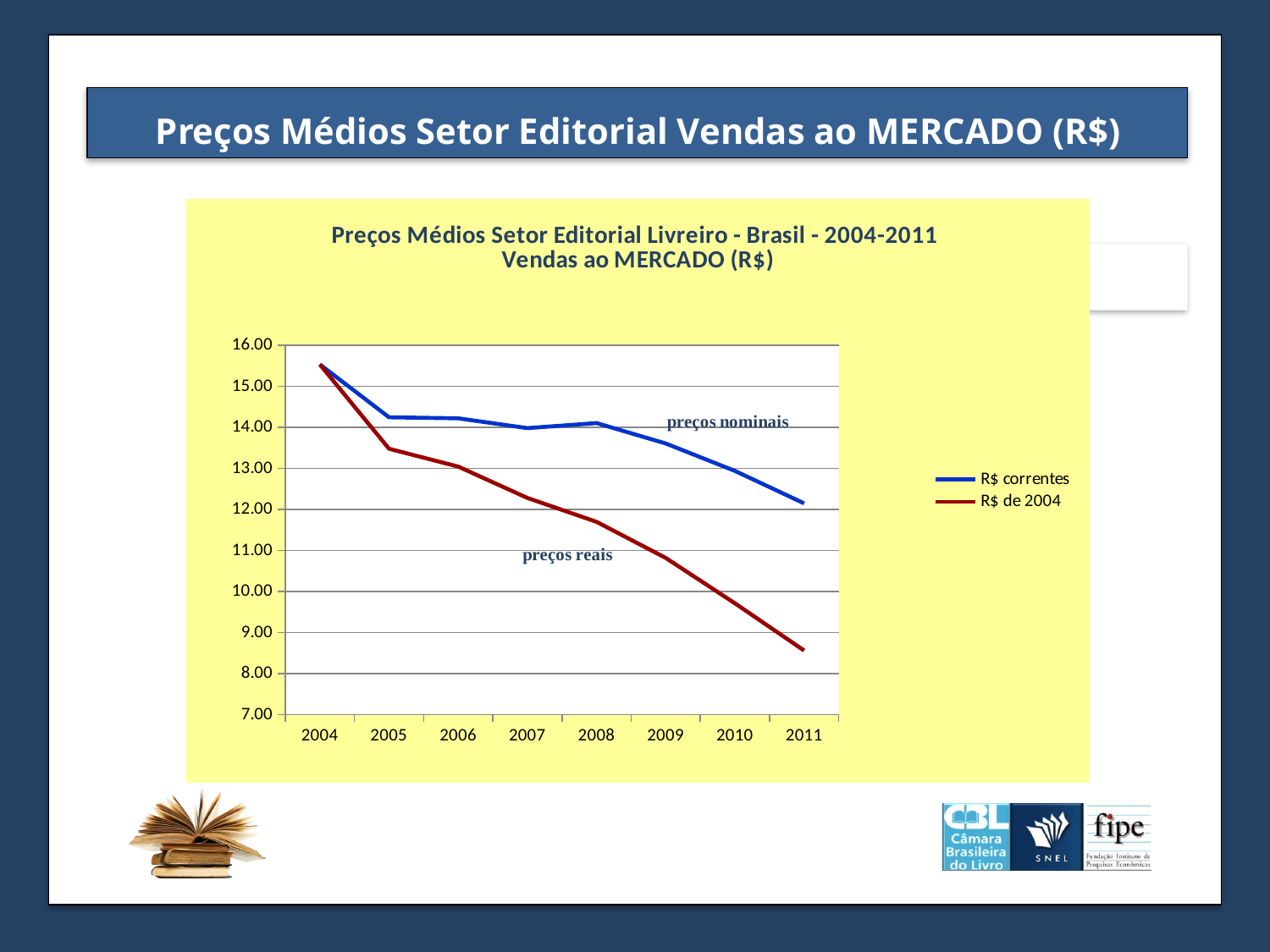
In 2011, which series has the higher value, R$ correntes or R$ de 2004? R$ correntes How many series does the legend list? 2 In which year is the R$ correntes series at its highest? 2004 Do the values of the R$ de 2004 series rise or fall from 2004 to 2011? fall Is the value for R$ correntes in 2009 greater or less than 13.00? greater Is the value for R$ de 2004 in 2008 greater or less than 11.00? greater Is the value for R$ de 2004 in 2011 greater or less than 9.00? less Which colour is used for the R$ de 2004 series? red In which year is the R$ de 2004 series at its lowest? 2011 What kind of chart is shown on the slide? line chart How many years are shown on the x axis? 8